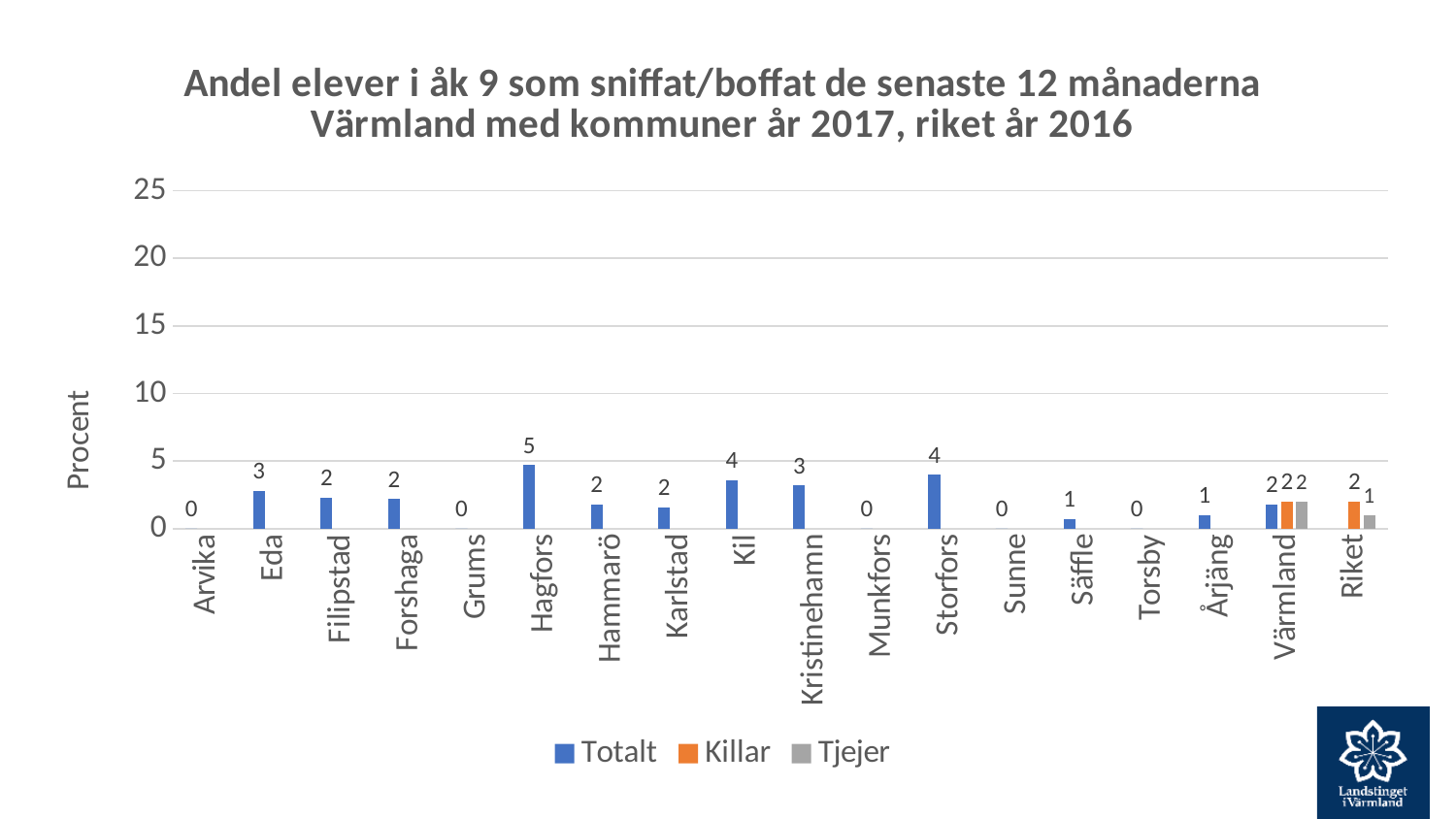
What is the label of the y axis? Procent Which municipality has the highest Totalt value? Hagfors How many series does the legend list? 3 Which has a larger Totalt value, Kil or Filipstad? Kil What is the difference between the Totalt values for Hagfors and Eda? 2 What is the Killar value for Riket? 2 How many categories are shown on the x axis? 18 Is the Totalt value for Hagfors greater or less than 10? less What kind of chart is shown on the slide? bar chart What is the Totalt value for Hagfors? 5 What is the Totalt value for Kristinehamn? 3 What is the Tjejer value for Riket? 1